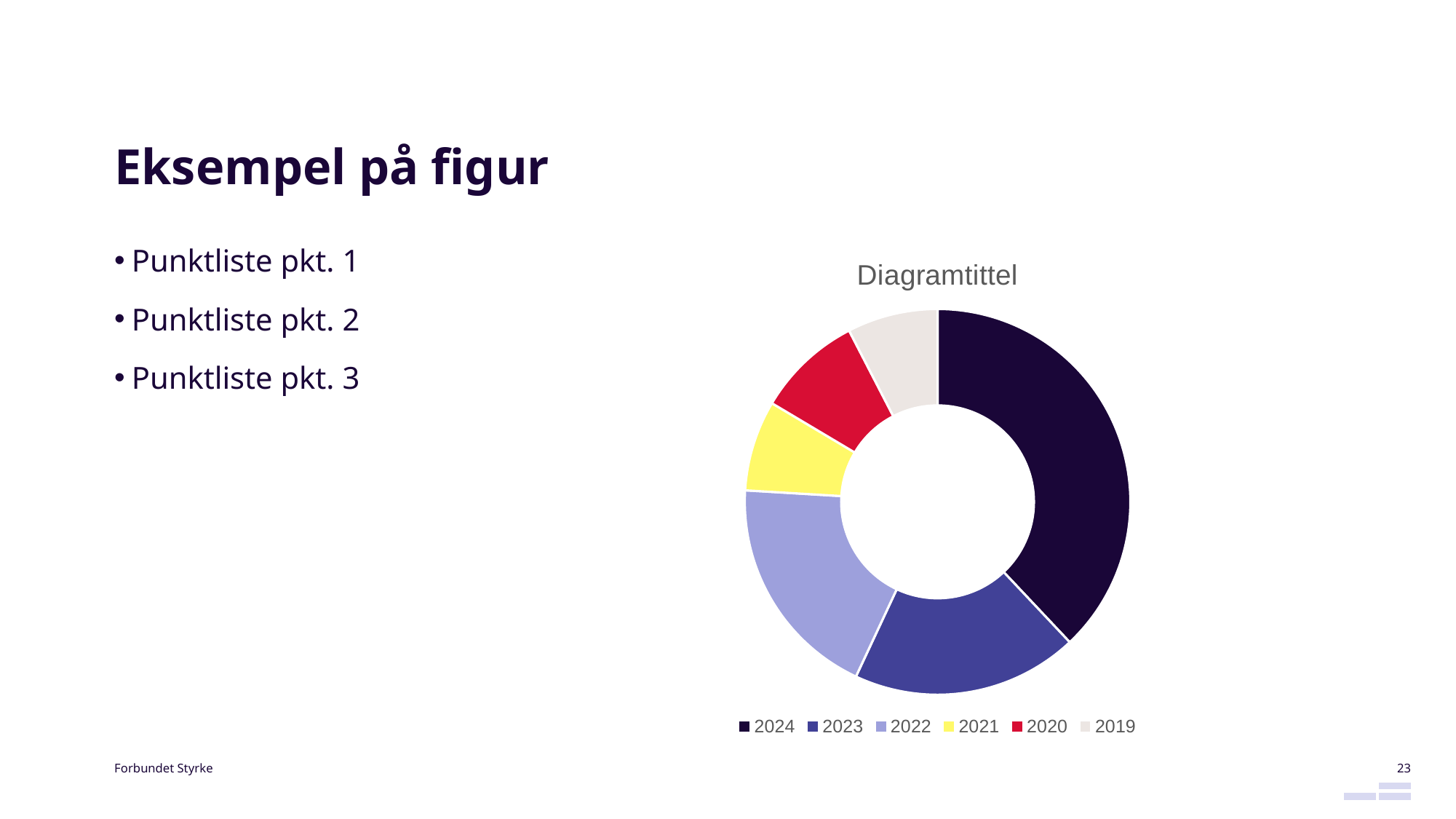
Which slice is larger, 2022 or 2021? 2022 Which category is shown in red in the chart? 2020 Which slice is larger, 2022 or 2020? 2022 Which category is listed first in the chart's legend? 2024 What kind of chart is shown on the slide? Doughnut chart Which slice is larger, 2024 or 2021? 2024 How many categories does the chart's legend list? 6 What is the title of the chart? Diagramtittel Which category has the largest slice in the chart? 2024